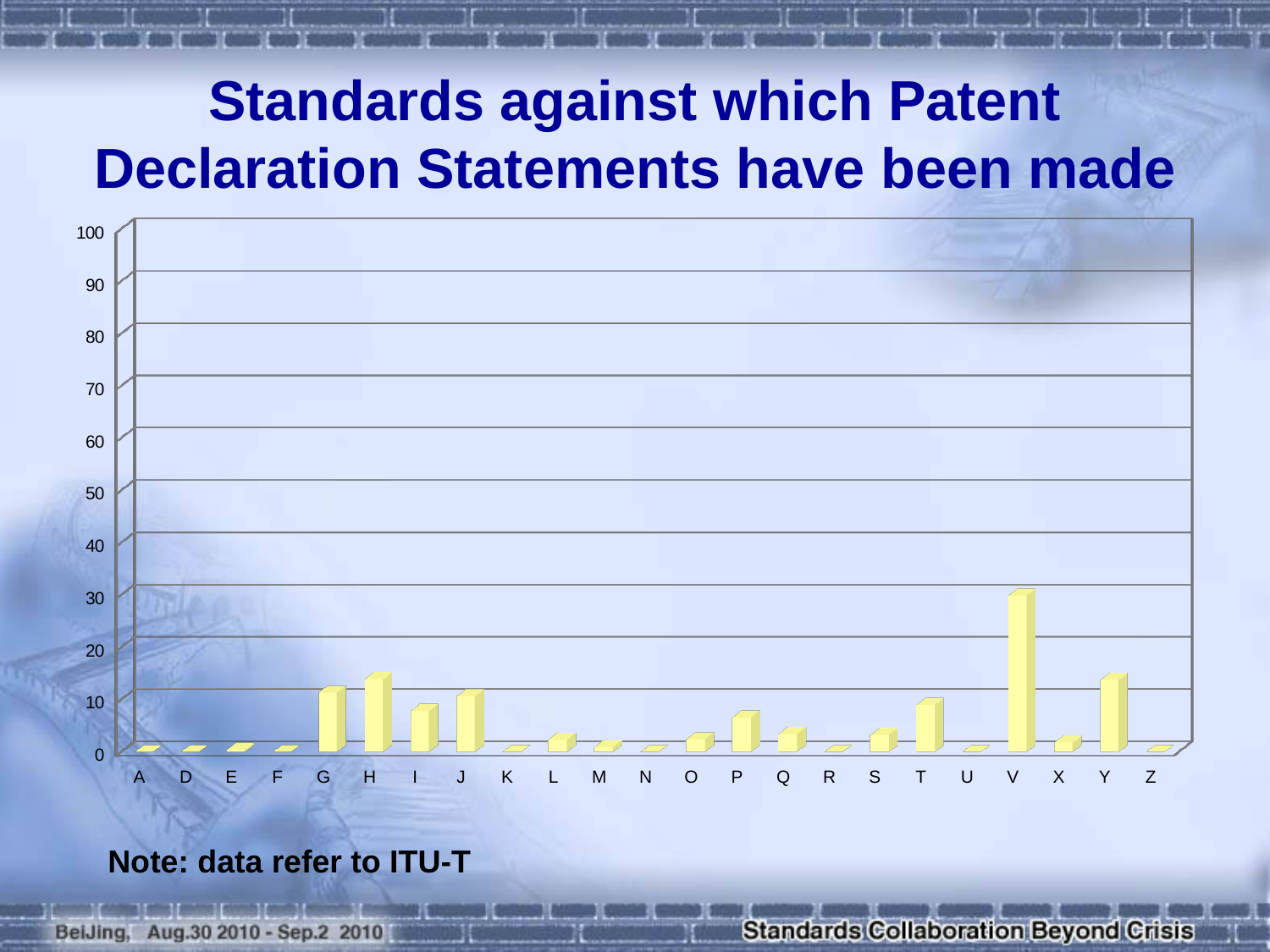
Is the value for V greater or less than 20? greater Is the value for H greater or less than 20? less How many categories are shown on the x axis of the chart? 23 Which is larger, the value for V or the value for Y? V Is the value for Y greater or less than 10? greater What is the maximum value shown on the y axis of the chart? 100 Which category has the highest value in the chart? V What is the title of the chart? Standards against which Patent Declaration Statements have been made What kind of chart is shown on the slide? bar chart Which is larger, the value for H or the value for P? H